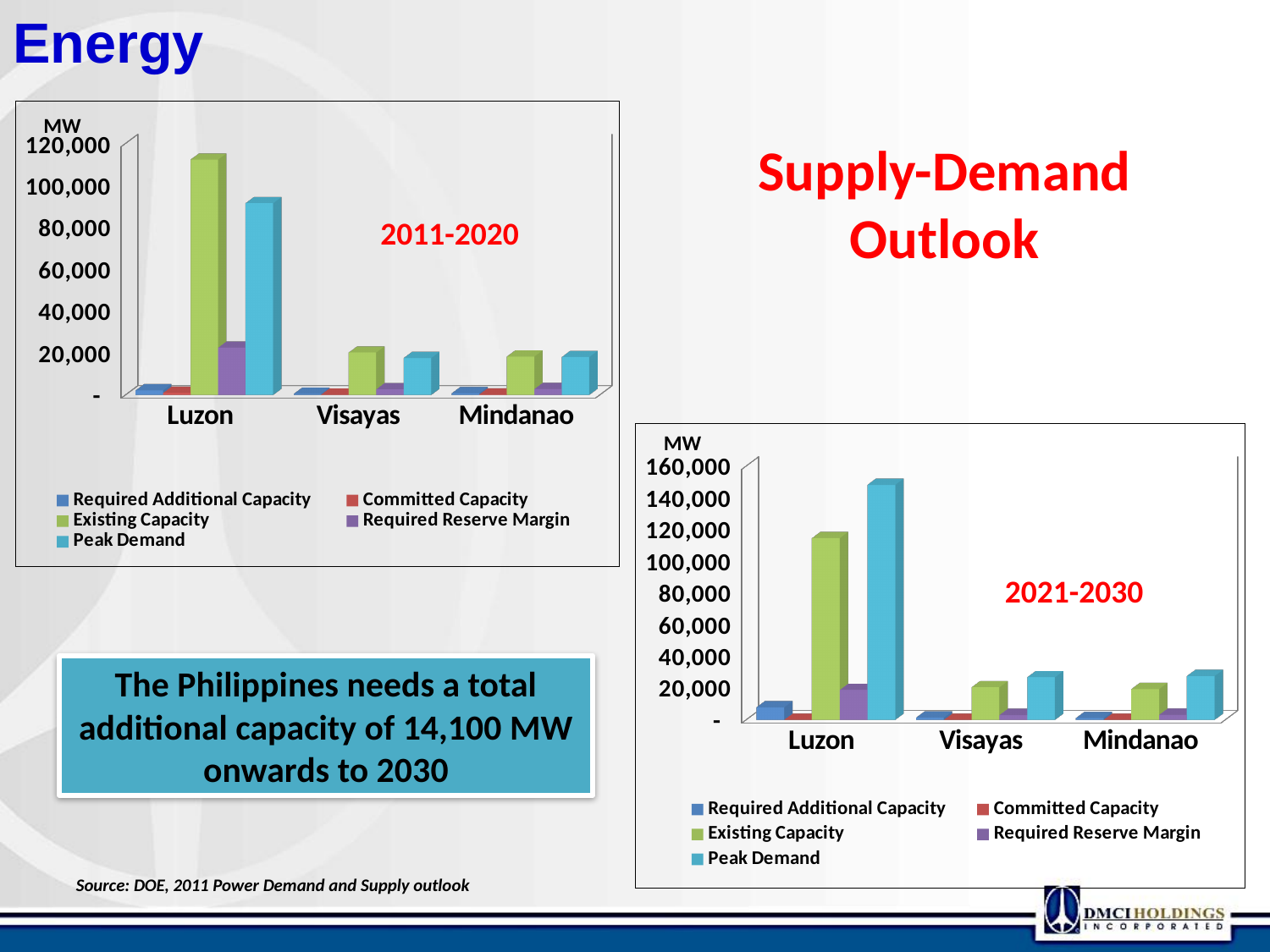
In the 2021-2030 chart, which is larger for Luzon: Existing Capacity or Peak Demand? Peak Demand What kind of chart is the 2011-2020 chart on the left? bar chart In the 2021-2030 chart, which region has the highest Peak Demand? Luzon In the 2011-2020 chart, which is larger for Luzon: Existing Capacity or Peak Demand? Existing Capacity In the 2021-2030 chart, is Existing Capacity for Luzon greater or less than 100,000? greater In the 2011-2020 chart, is Existing Capacity for Luzon greater or less than 100,000? greater In the 2021-2030 chart, is Peak Demand for Luzon greater or less than 120,000? greater How many regions are shown on the x axis of the 2011-2020 chart? 3 How many series does the legend of the 2021-2030 chart list? 5 What unit is shown on the vertical axis of the 2021-2030 chart? MW In the 2011-2020 chart, which region has the highest Existing Capacity? Luzon